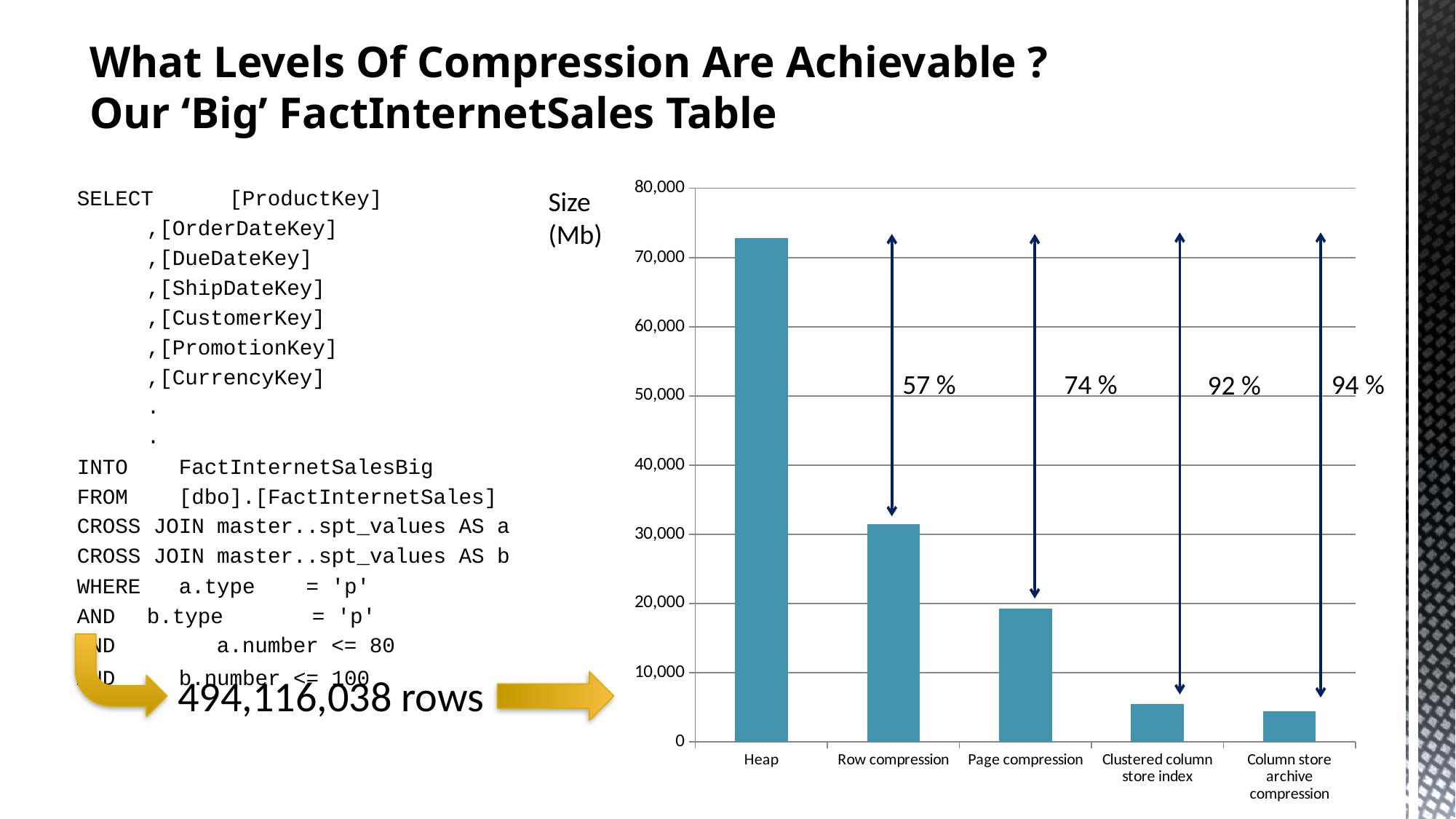
What is the label of the y axis of the chart? Size (Mb) Which is larger, the value for Row compression or the value for Page compression? Row compression What compression percentage is annotated above the Page compression bar? 74 % Is the value for Page compression greater or less than 20,000? less Which category has the smallest size in the chart? Column store archive compression Is the value for Heap greater or less than 70,000? greater Do the bar values rise or fall moving from left to right along the x axis? fall What kind of chart is shown on the slide? Bar chart Which category has the largest size in the chart? Heap Is the value for Clustered column store index greater or less than 10,000? less How many categories are shown on the x axis of the chart? 5